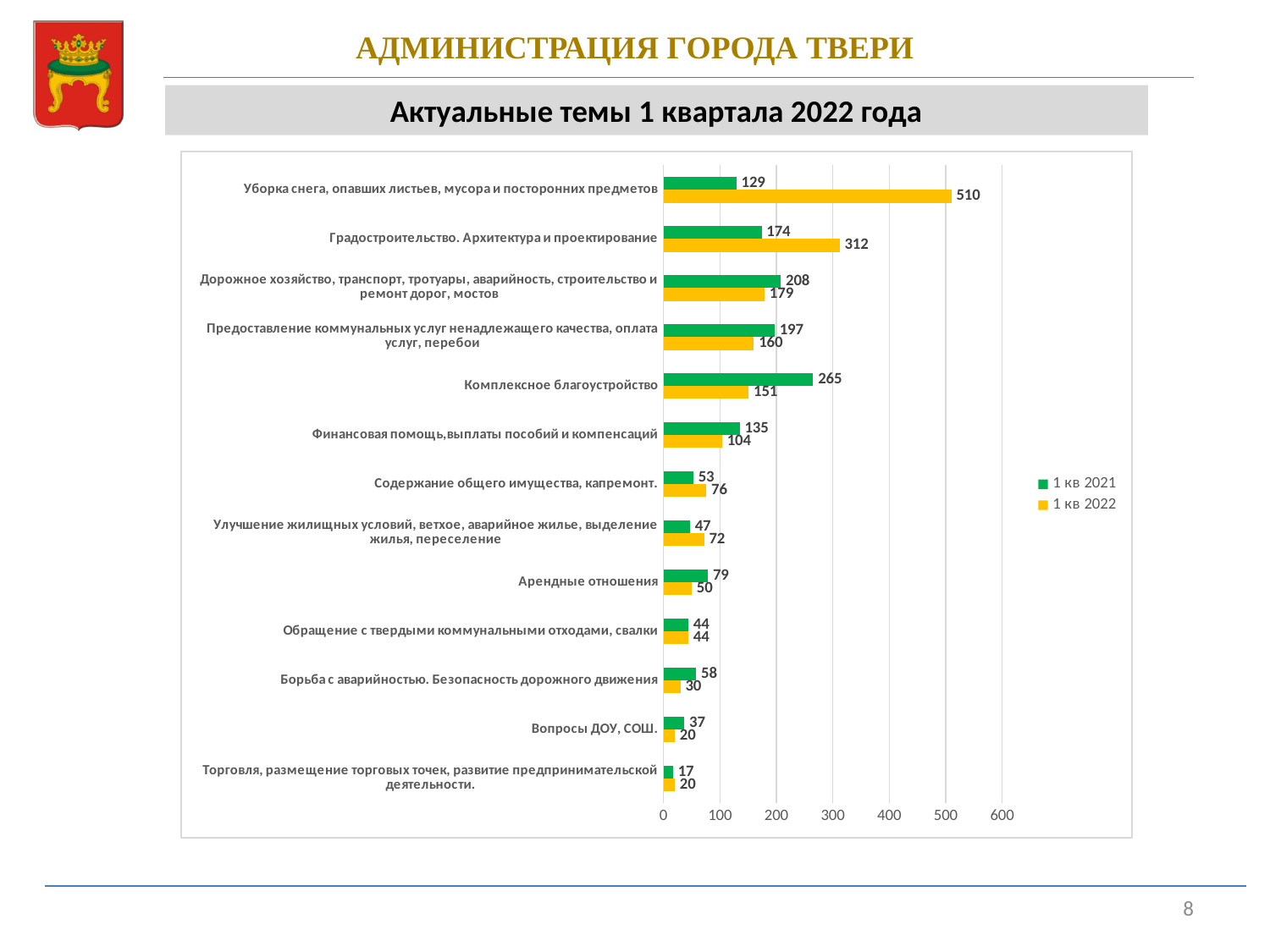
For "Дорожное хозяйство, транспорт, тротуары, аварийность, строительство и ремонт дорог, мостов", which series has the larger value, "1 кв 2021" or "1 кв 2022"? 1 кв 2021 How many categories are shown on the chart? 13 What is the difference between the "1 кв 2022" and "1 кв 2021" values for "Градостроительство. Архитектура и проектирование"? 138 How many series does the legend list? 2 What is the value for "Уборка снега, опавших листьев, мусора и посторонних предметов" in the "1 кв 2022" series? 510 Which category has the highest value in the "1 кв 2022" series? Уборка снега, опавших листьев, мусора и посторонних предметов What kind of chart is shown on the slide? bar chart What is the value for "Комплексное благоустройство" in the "1 кв 2021" series? 265 Which category has the lowest value in the "1 кв 2021" series? Торговля, размещение торговых точек, развитие предпринимательской деятельности. What is the value for "Арендные отношения" in the "1 кв 2022" series? 50 What is the total of the two series values for "Обращение с твердыми коммунальными отходами, свалки"? 88 Is the "1 кв 2022" value for "Уборка снега, опавших листьев, мусора и посторонних предметов" greater or less than 500? greater